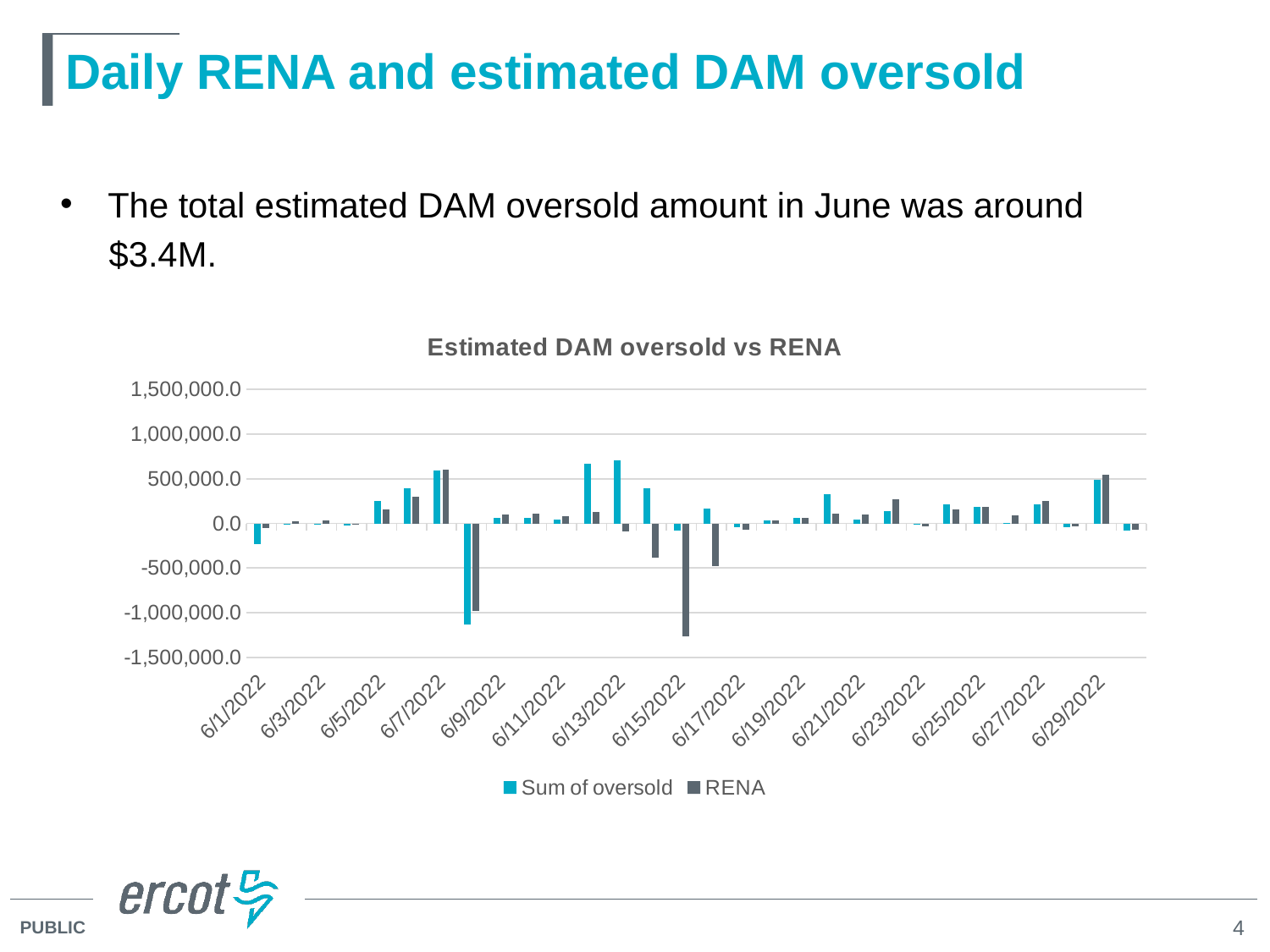
How many series does the chart legend list? 2 What kind of chart is shown on the slide? Bar chart What are the two series named in the chart legend? Sum of oversold and RENA What is the lowest value shown on the chart's y axis? -1,500,000.0 Is the highest Sum of oversold value on the chart greater or less than 500,000.0? greater How many date labels are shown along the x axis of the chart? 15 Is the lowest RENA value on the chart greater or less than -1,000,000.0? less What is the first date label on the x axis of the chart? 6/1/2022 What is the title of the chart? Estimated DAM oversold vs RENA Is the highest Sum of oversold value on the chart greater or less than 1,000,000.0? less What is the last date label on the x axis of the chart? 6/29/2022 What is the highest value shown on the chart's y axis? 1,500,000.0